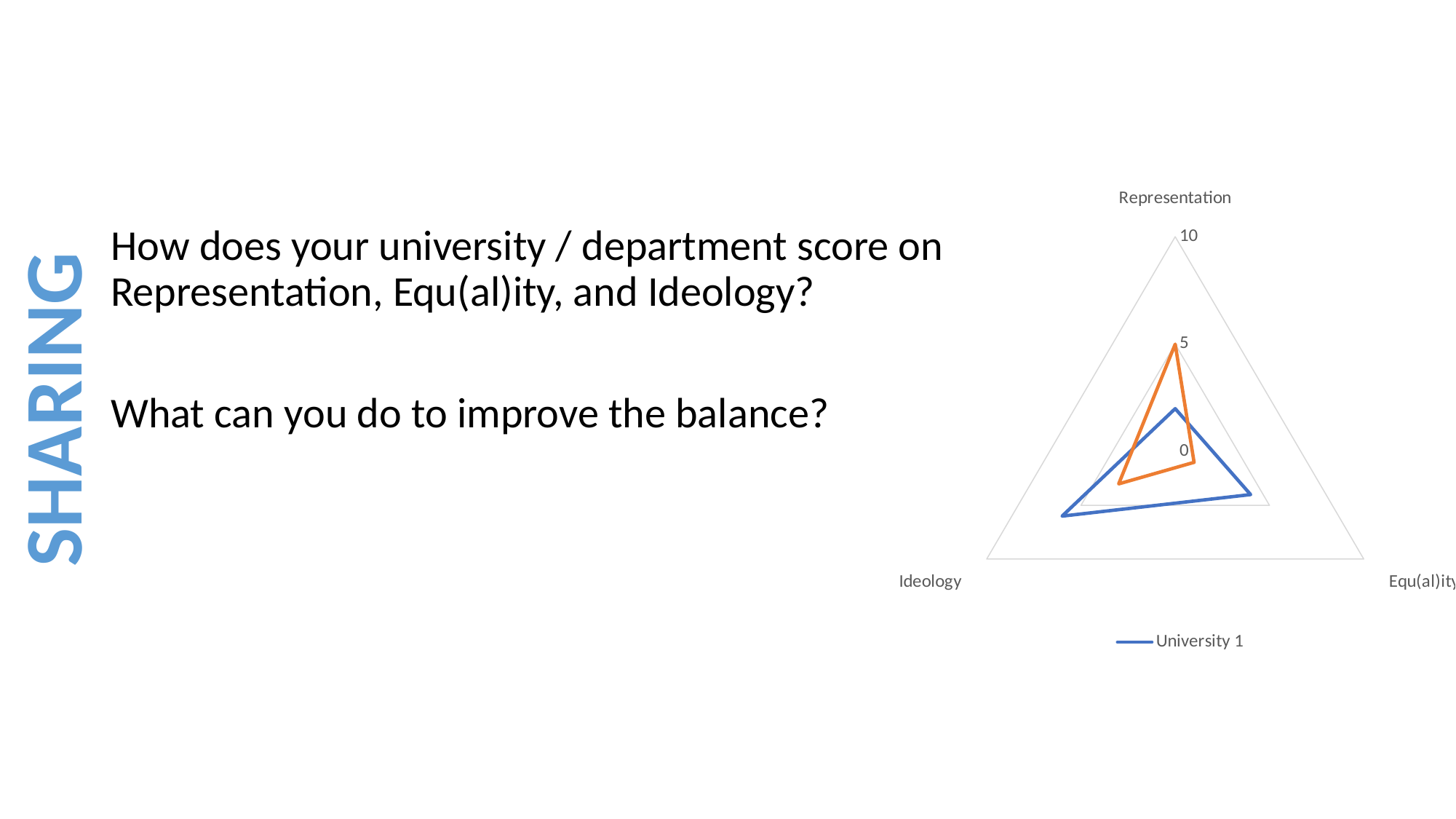
How many axes (categories) does the radar chart have? 3 What is the name of the series listed in the legend? University 1 On which axis does the University 1 (blue) series reach its highest value? Ideology On which axis does the orange series reach its highest value? Representation Is the University 1 (blue) value for Representation greater or less than 5? less Is the orange series value for Equ(al)ity greater or less than 5? less Which series has the larger value for Representation, University 1 (blue) or the orange series? the orange series On which axis does the orange series have its lowest value? Equ(al)ity Is the University 1 (blue) value for Equ(al)ity greater or less than 5? less What is the highest value shown on the chart's axis scale? 10 How many series does the chart legend list? 1 What kind of chart is shown on the slide? radar chart